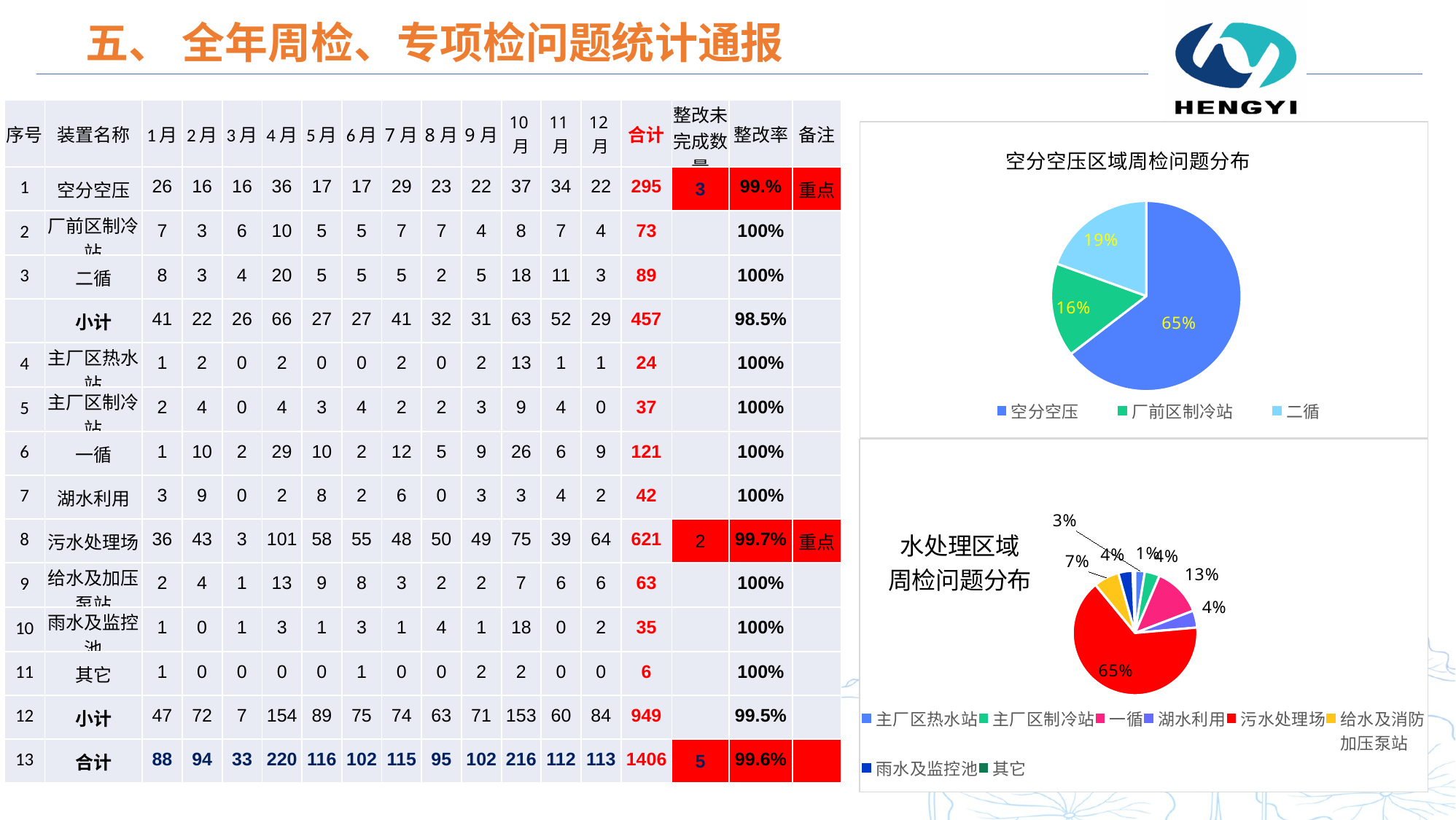
In the chart titled 空分空压区域周检问题分布, which category has the smallest share? 厂前区制冷站 In the chart titled 空分空压区域周检问题分布, what share does 二循 have? 19% In the chart titled 水处理区域周检问题分布, what share does 一循 have? 13% In the chart titled 水处理区域周检问题分布, what share does 给水及消防加压泵站 have? 7% In the chart titled 空分空压区域周检问题分布, what share does 空分空压 have? 65% In the chart titled 水处理区域周检问题分布, how many categories does the legend list? 8 In the chart titled 空分空压区域周检问题分布, how many categories does the legend list? 3 In the chart titled 空分空压区域周检问题分布, what share does 厂前区制冷站 have? 16% What kind of chart is the chart titled 水处理区域周检问题分布? pie chart In the chart titled 空分空压区域周检问题分布, which category has the largest share? 空分空压 In the chart titled 空分空压区域周检问题分布, what is the difference in percentage points between 空分空压 and 二循? 46 In the chart titled 水处理区域周检问题分布, what share does 污水处理场 have? 65%